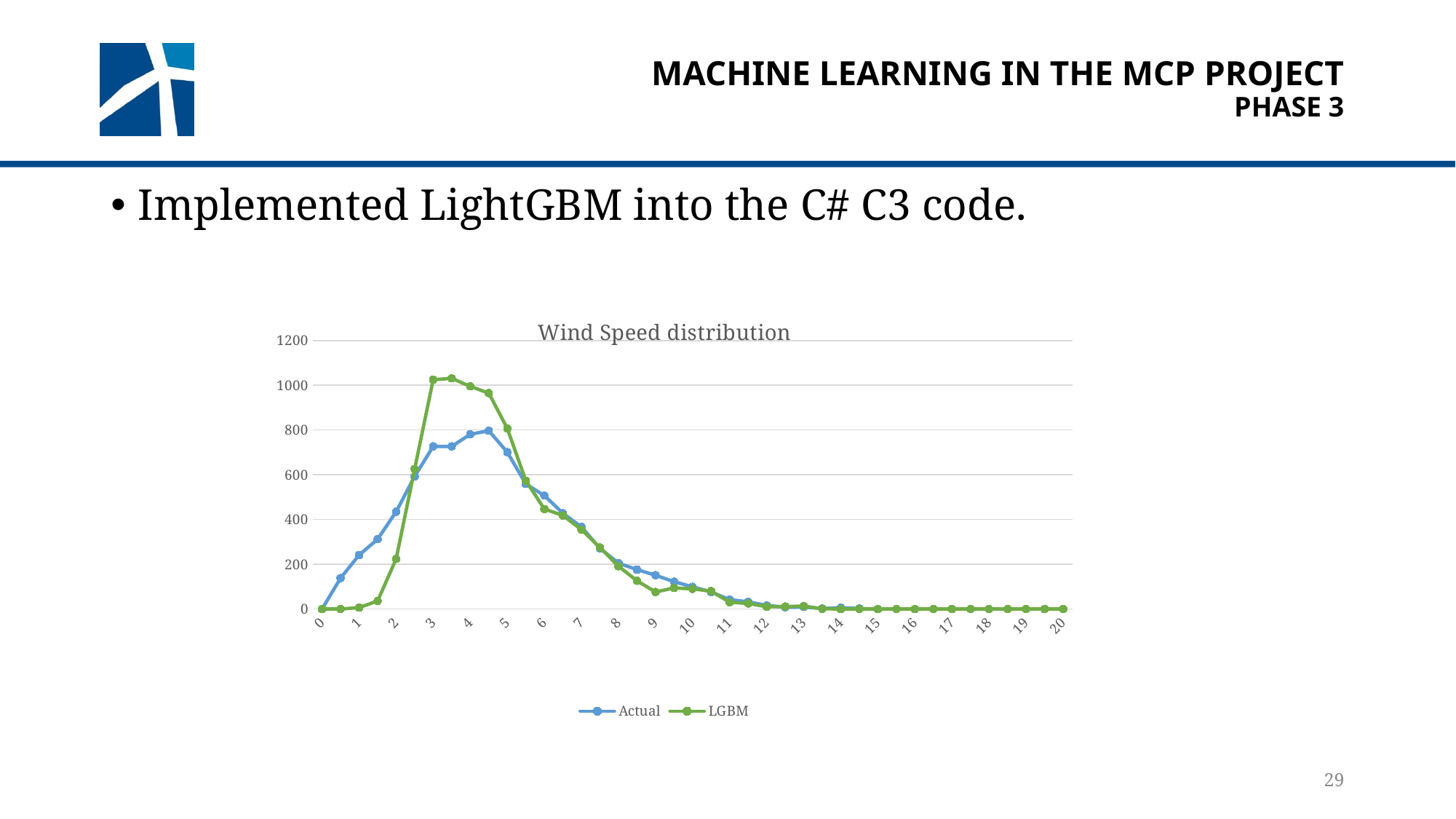
Between wind speed 5 and wind speed 12, do the Actual values rise or fall? fall Is the Actual value at wind speed 4 greater or less than 1000? less Is the Actual value at wind speed 2 greater or less than 200? greater What is the title of the chart? Wind Speed distribution At wind speed 3, which series has the higher value, Actual or LGBM? LGBM How many series does the legend of the chart list? 2 What is the Actual value at wind speed 0? 0 Is the LGBM value at wind speed 2 greater or less than 400? less What kind of chart is shown on the slide? line chart At wind speed 1, which series has the higher value, Actual or LGBM? Actual What are the two series named in the chart legend? Actual and LGBM